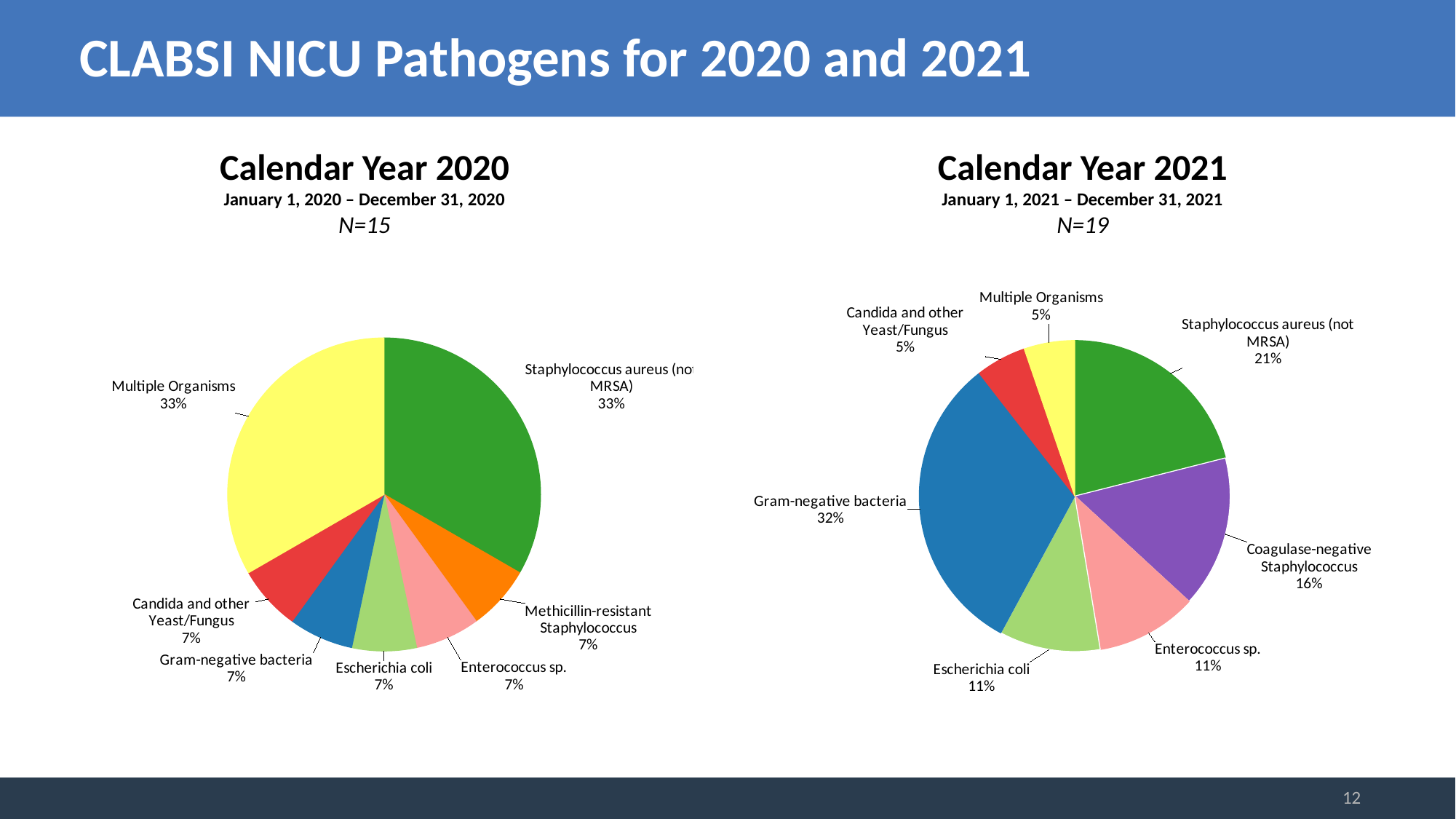
In the Calendar Year 2020 chart, which is larger, Staphylococcus aureus (not MRSA) or Gram-negative bacteria? Staphylococcus aureus (not MRSA) In the Calendar Year 2020 chart, what is the value for Methicillin-resistant Staphylococcus? 7% In the Calendar Year 2021 chart, what is the value for Coagulase-negative Staphylococcus? 16% In the Calendar Year 2021 chart, which is larger, Escherichia coli or Multiple Organisms? Escherichia coli In the Calendar Year 2021 chart, what is the difference between Staphylococcus aureus (not MRSA) and Coagulase-negative Staphylococcus? 5% How many categories are shown in the Calendar Year 2021 chart? 7 In the Calendar Year 2021 chart, what share of the pie is Gram-negative bacteria? 32% In the Calendar Year 2020 chart, what share of the pie is Multiple Organisms? 33% How many categories are shown in the Calendar Year 2020 chart? 7 In the Calendar Year 2021 chart, which category has the largest share? Gram-negative bacteria What is the N value shown under the Calendar Year 2021 chart title? N=19 What kind of chart is the Calendar Year 2020 chart? Pie chart